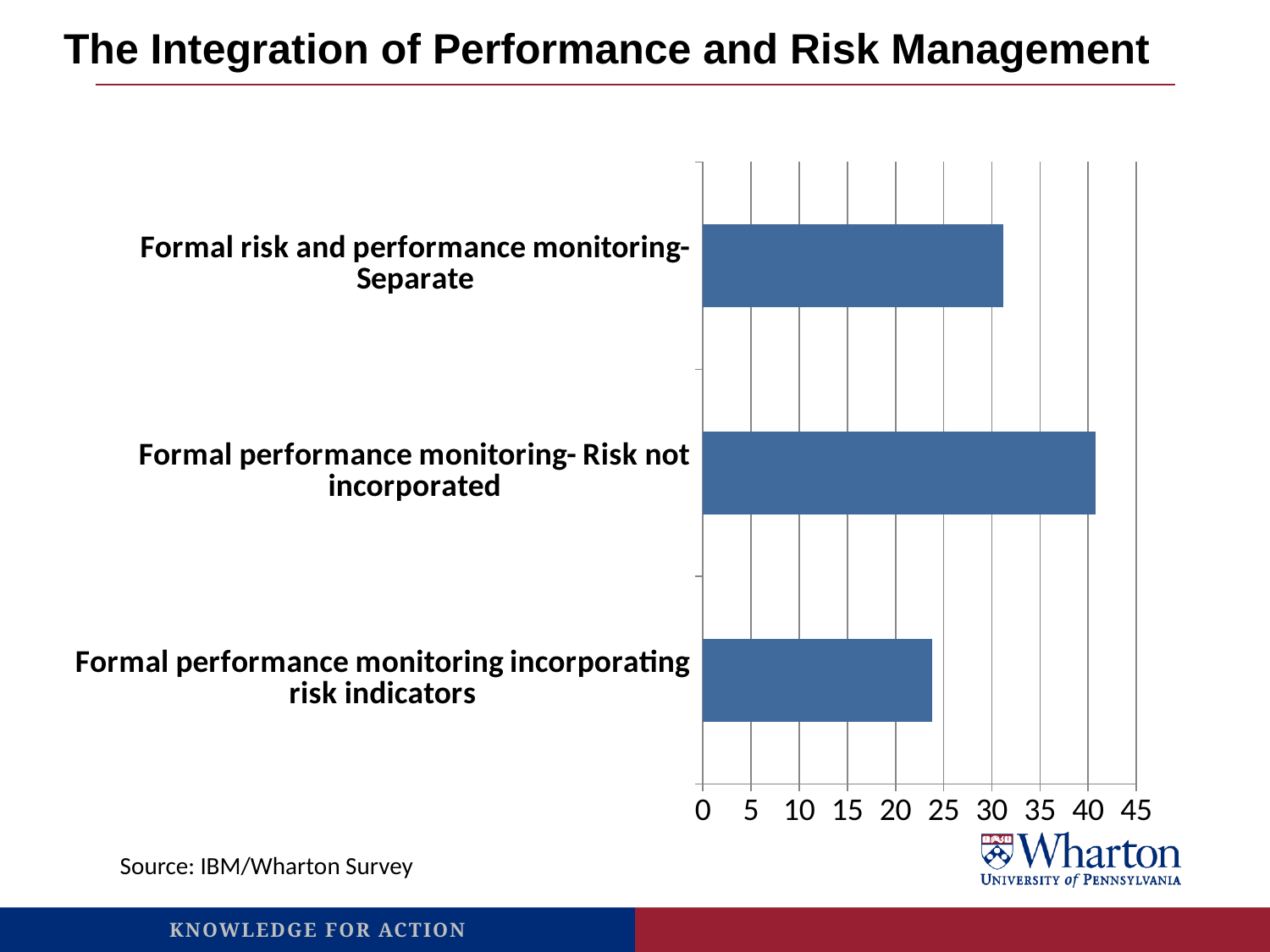
What kind of chart is shown on the slide? bar chart Is the value for 'Formal performance monitoring- Risk not incorporated' greater or less than 45? less Is the value for 'Formal risk and performance monitoring- Separate' greater or less than 35? less Is the value for 'Formal performance monitoring- Risk not incorporated' greater or less than 35? greater What is the title of the slide containing the chart? The Integration of Performance and Risk Management Which category has the lowest value? Formal performance monitoring incorporating risk indicators Which is larger: the value for 'Formal performance monitoring- Risk not incorporated' or for 'Formal risk and performance monitoring- Separate'? Formal performance monitoring- Risk not incorporated Which is larger: the value for 'Formal risk and performance monitoring- Separate' or for 'Formal performance monitoring incorporating risk indicators'? Formal risk and performance monitoring- Separate Which category has the highest value? Formal performance monitoring- Risk not incorporated How many categories are plotted in the chart? 3